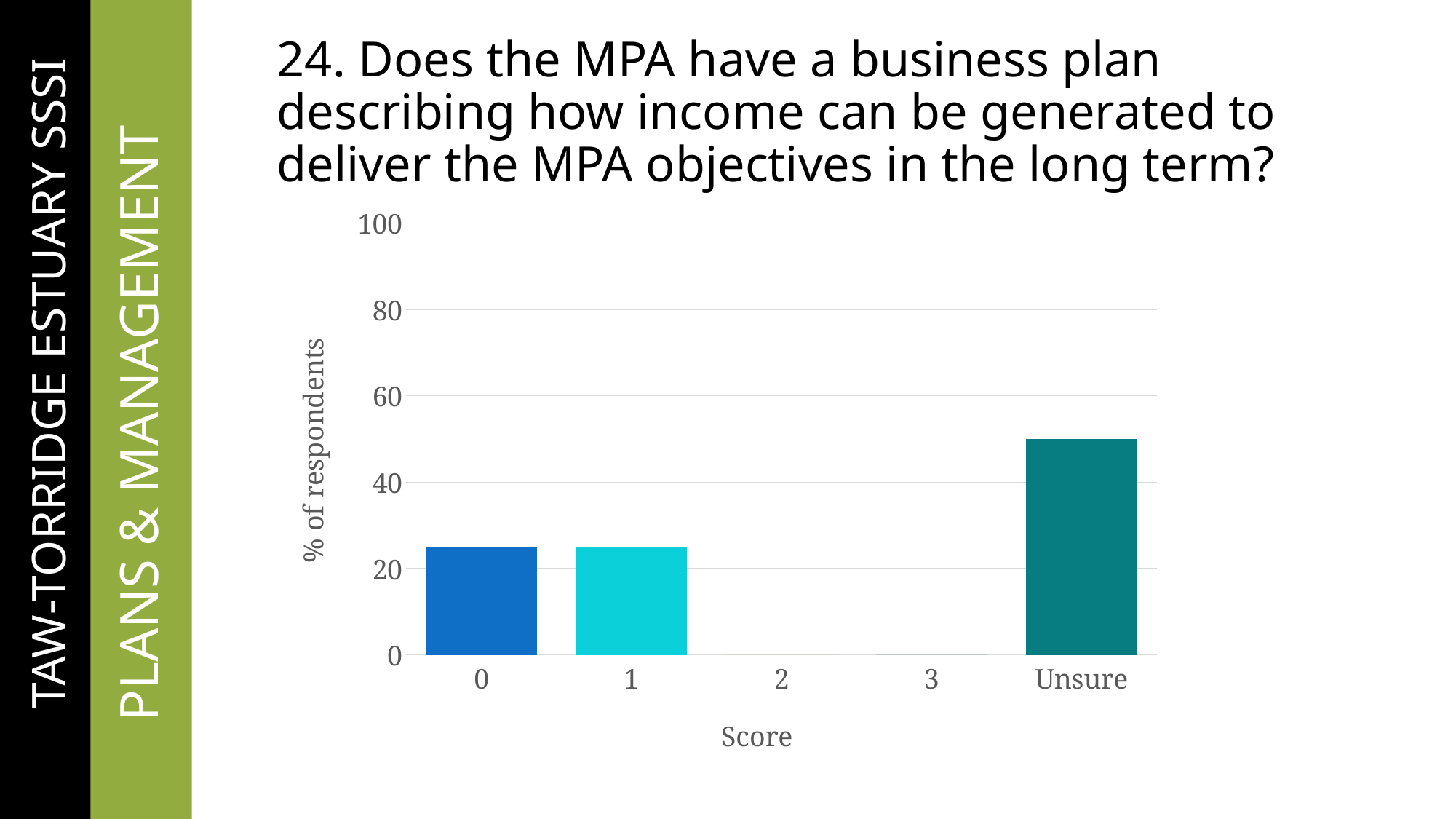
What is the label of the x axis? Score Is the value for score 0 greater or less than 20? greater Which score category has the highest percentage of respondents? Unsure How many score categories are shown on the x axis? 5 What kind of chart is shown on the slide? bar chart Which is larger, the value for Unsure or the value for score 0? Unsure Is the value for score 1 greater or less than 40? less What is the percentage of respondents for score 2? 0 Is the value for Unsure greater or less than 40? greater What is the label of the y axis? % of respondents What is the percentage of respondents for score 3? 0